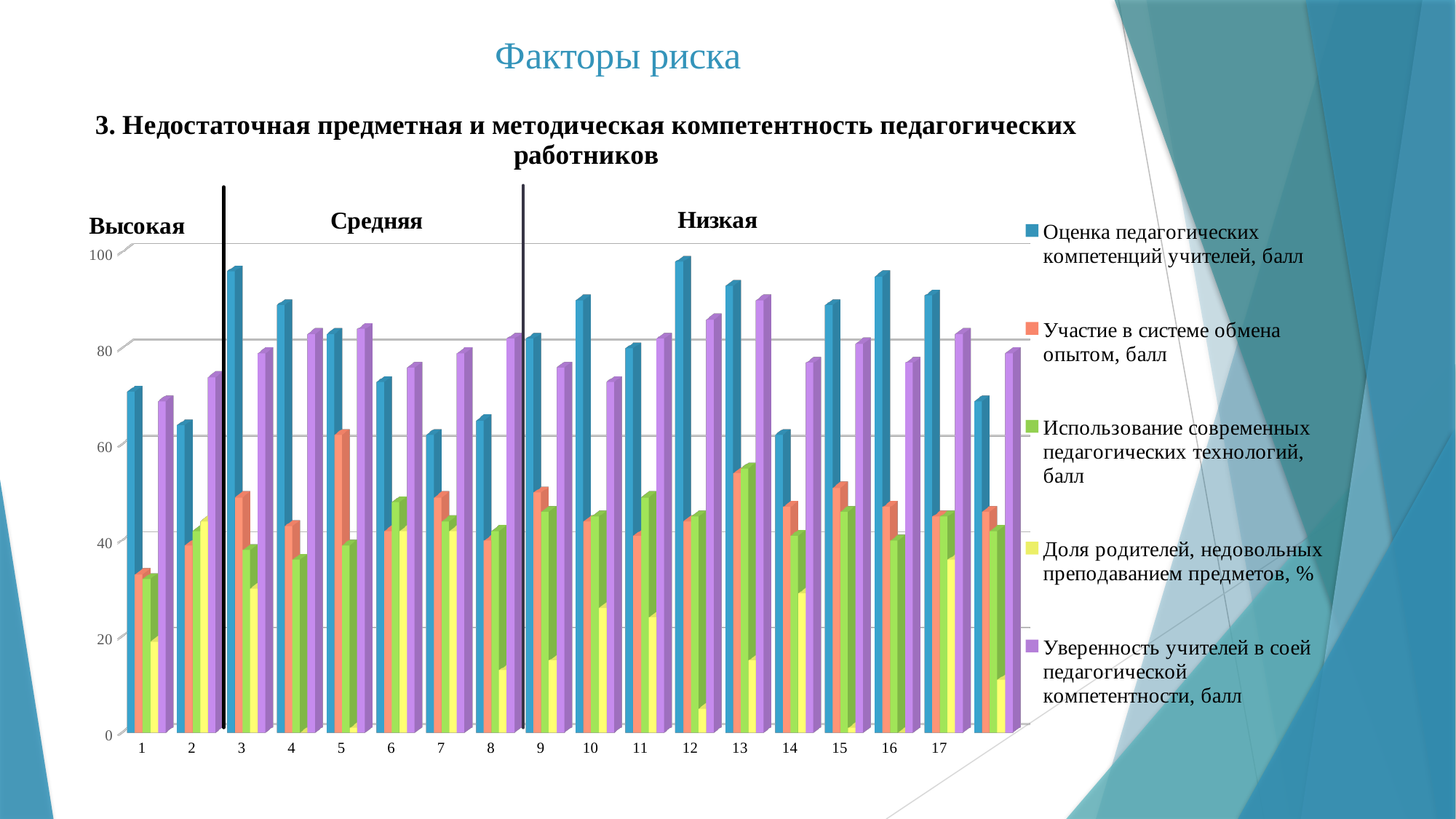
Is the value of 'Участие в системе обмена опытом, балл' for category 1 greater or less than 40? less What kind of chart is shown on the slide? bar chart Is the value of 'Уверенность учителей в соей педагогической компетентности, балл' for category 13 greater or less than 80? greater Is the value of 'Использование современных педагогических технологий, балл' for category 13 greater or less than 40? greater For which category is 'Участие в системе обмена опытом, балл' highest? 5 Which is larger for 'Оценка педагогических компетенций учителей, балл': category 2 or category 3? category 3 How many series does the legend list? 5 What colour represents 'Доля родителей, недовольных преподаванием предметов, %' in the legend? yellow What are the three zone labels written above the chart from left to right? Высокая, Средняя, Низкая Which is larger for 'Уверенность учителей в соей педагогической компетентности, балл': category 1 or category 3? category 3